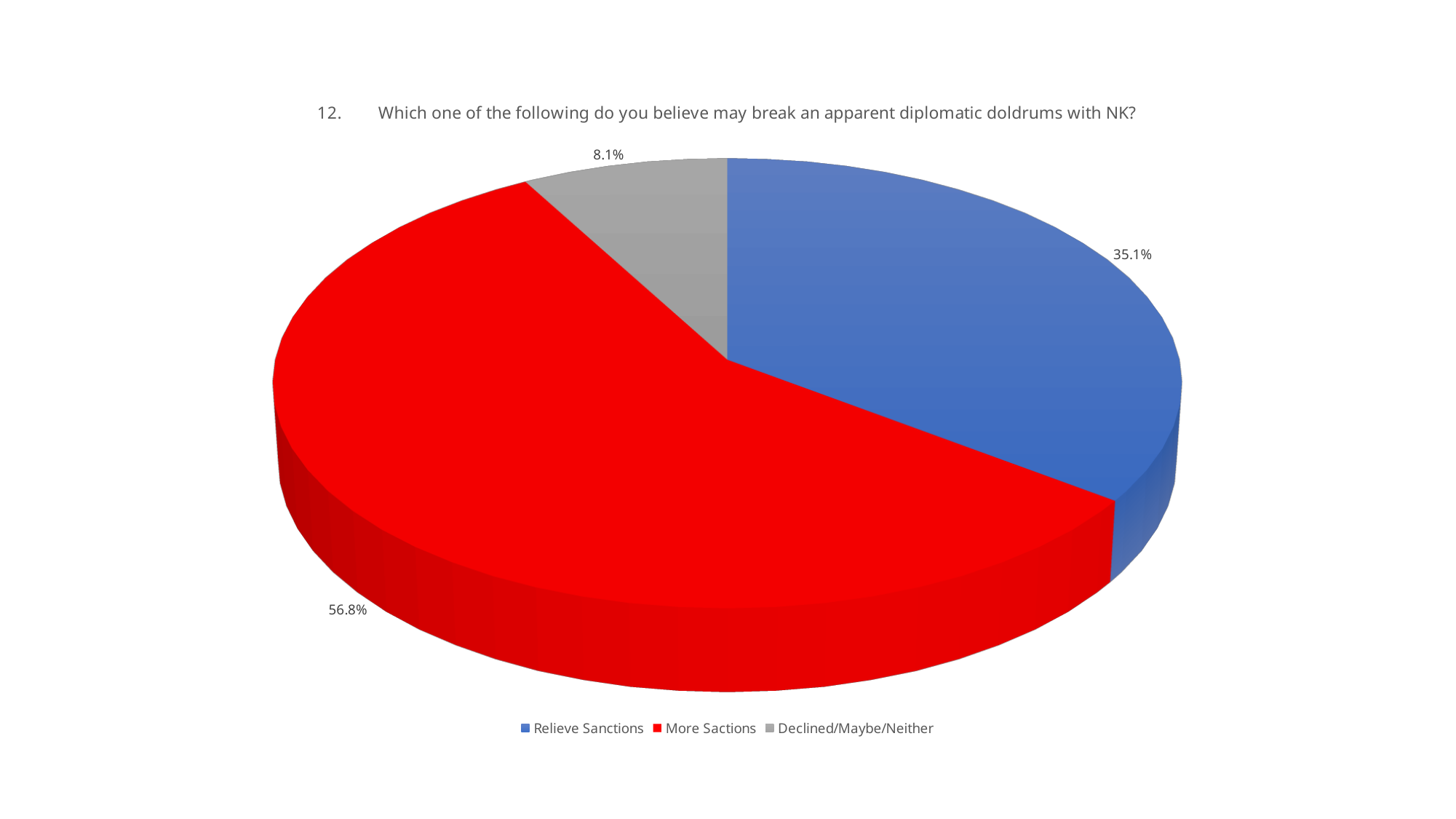
What colour is the slice for More Sactions? Red What percentage of respondents chose More Sactions? 56.8% What type of chart is shown on the slide? Pie chart Which category has the smallest share of the pie? Declined/Maybe/Neither Which category has the largest share of the pie? More Sactions What percentage is shown for Declined/Maybe/Neither? 8.1% Which is larger, the share for Relieve Sanctions or the share for Declined/Maybe/Neither? Relieve Sanctions What percentage of respondents chose Relieve Sanctions? 35.1% What is the title of the chart? 12. Which one of the following do you believe may break an apparent diplomatic doldrums with NK? What is the difference in percentage points between More Sactions and Relieve Sanctions? 21.7 How many categories does the pie chart show? 3 How many entries does the legend list? 3